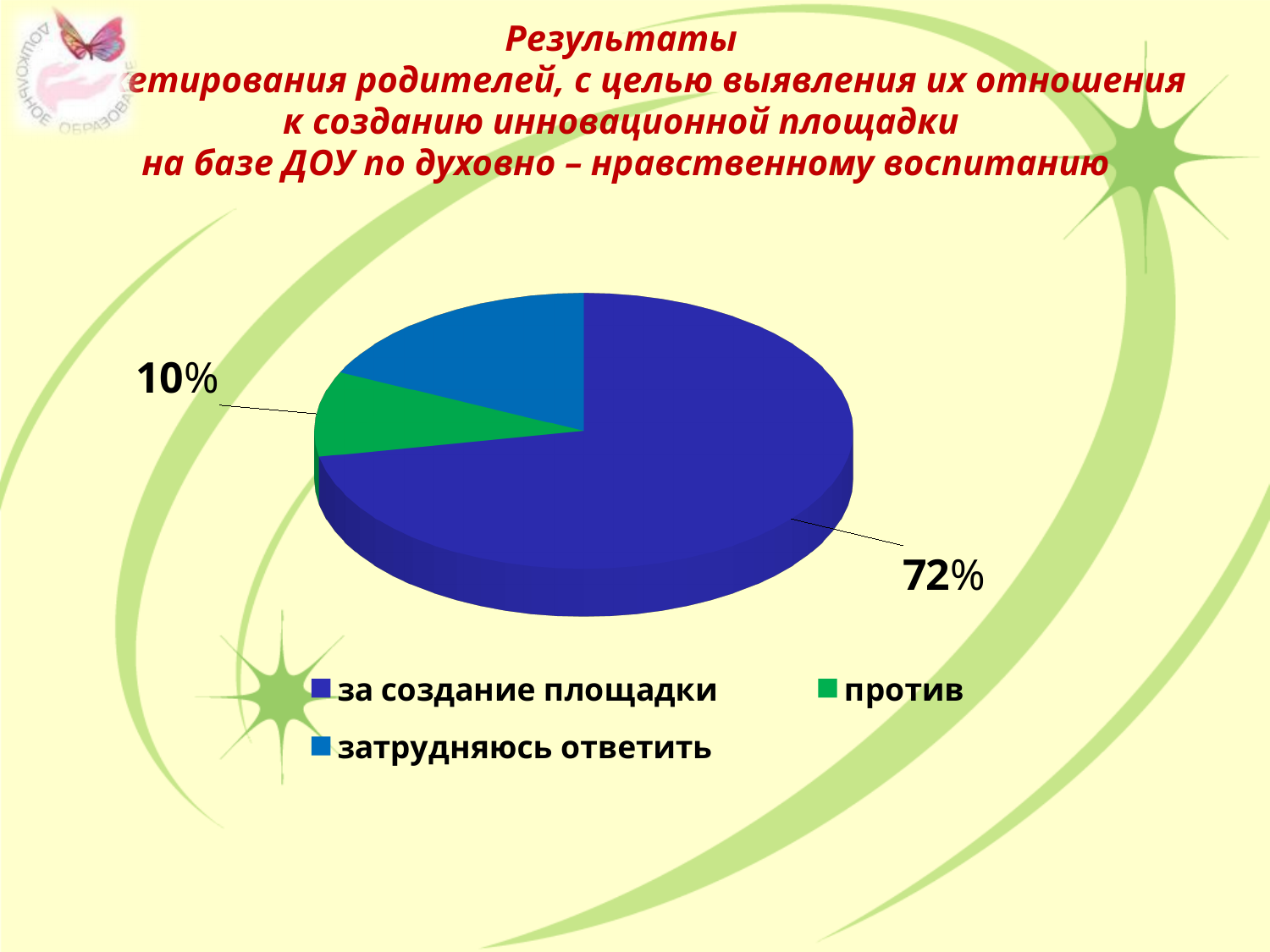
Which category has the smallest slice of the pie? против How many entries does the legend list? 3 What percentage of parents are "за создание площадки"? 72% Which is larger: the share for "за создание площадки" or the share for "против"? за создание площадки What share of the pie does the "за создание площадки" slice represent? 72% Which legend entry is shown in light blue? затрудняюсь ответить Which category has the largest slice of the pie? за создание площадки What percentage of parents are "против"? 10% How many categories does the pie chart have? 3 What kind of chart is shown on the slide? pie chart What colour is the "против" slice in the pie chart? green What is the difference in percentage points between "за создание площадки" and "против"? 62